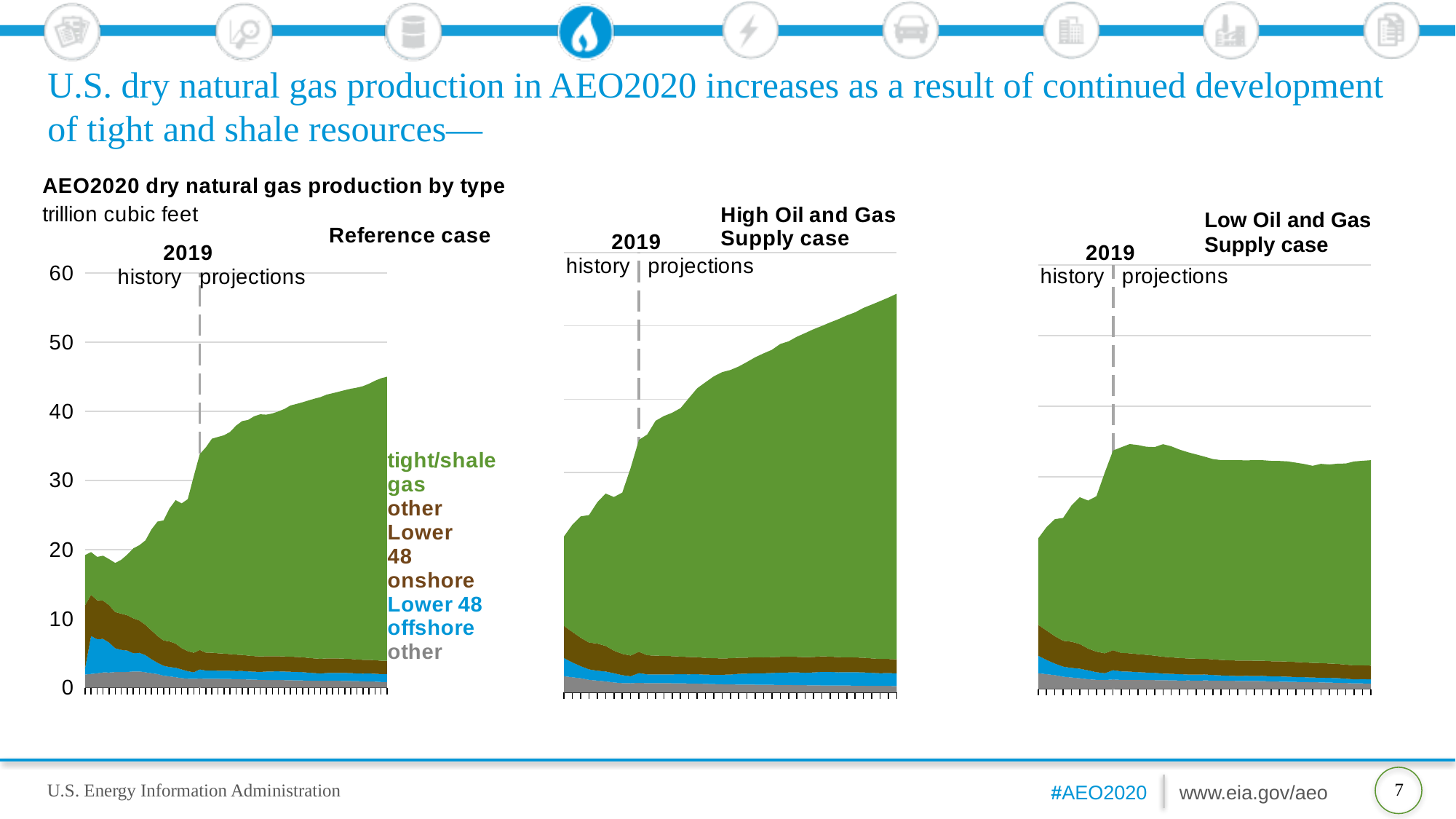
How many series does the legend list for the dry natural gas production charts? 4 In the Low Oil and Gas Supply case chart, is total production at the end of the projection period greater or less than 40 trillion cubic feet? less In the Reference case chart, which series accounts for the largest share of production at the end of the projection period? tight/shale gas What unit is used on the y axis of the dry natural gas production charts? trillion cubic feet In the Reference case chart, is total production at the end of the projection period greater or less than 40 trillion cubic feet? greater What year marks the boundary between history and projections on the charts? 2019 In the Low Oil and Gas Supply case chart, does total production rise sharply or stay roughly flat over the projection period? roughly flat In the High Oil and Gas Supply case chart, does total production rise or fall over the projection period? rise In the Reference case chart, is total production at the start of the history period greater or less than 30 trillion cubic feet? less Which of the three cases shows the highest total production at the end of the projection period? High Oil and Gas Supply case What kind of chart is used for the Reference case panel? stacked area chart